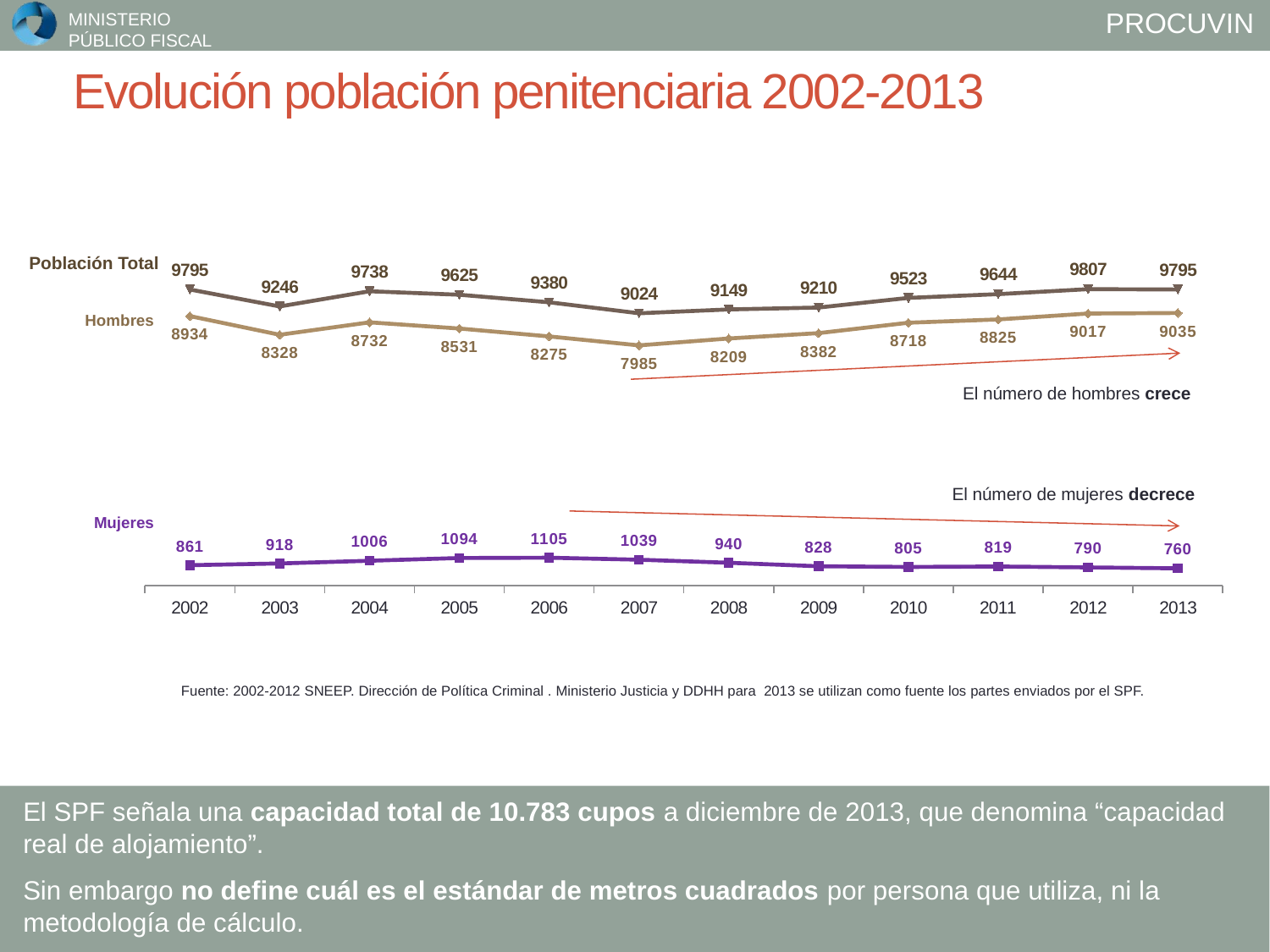
How many series are plotted in the chart? 3 Which is larger, the Mujeres value in 2004 or in 2008? 2004 In which year is the Mujeres series at its highest? 2006 What is the value of Mujeres in 2005? 1094 What is the difference between the Hombres value in 2013 and in 2002? 101 How many years are shown on the x axis? 12 What is the value of Hombres in 2010? 8718 What is the value of Población Total in 2007? 9024 What is the difference between the Mujeres value in 2006 and in 2013? 345 In which year is the Hombres series at its lowest? 2007 What type of chart is shown on the slide? Line chart In which year is Población Total at its highest? 2012